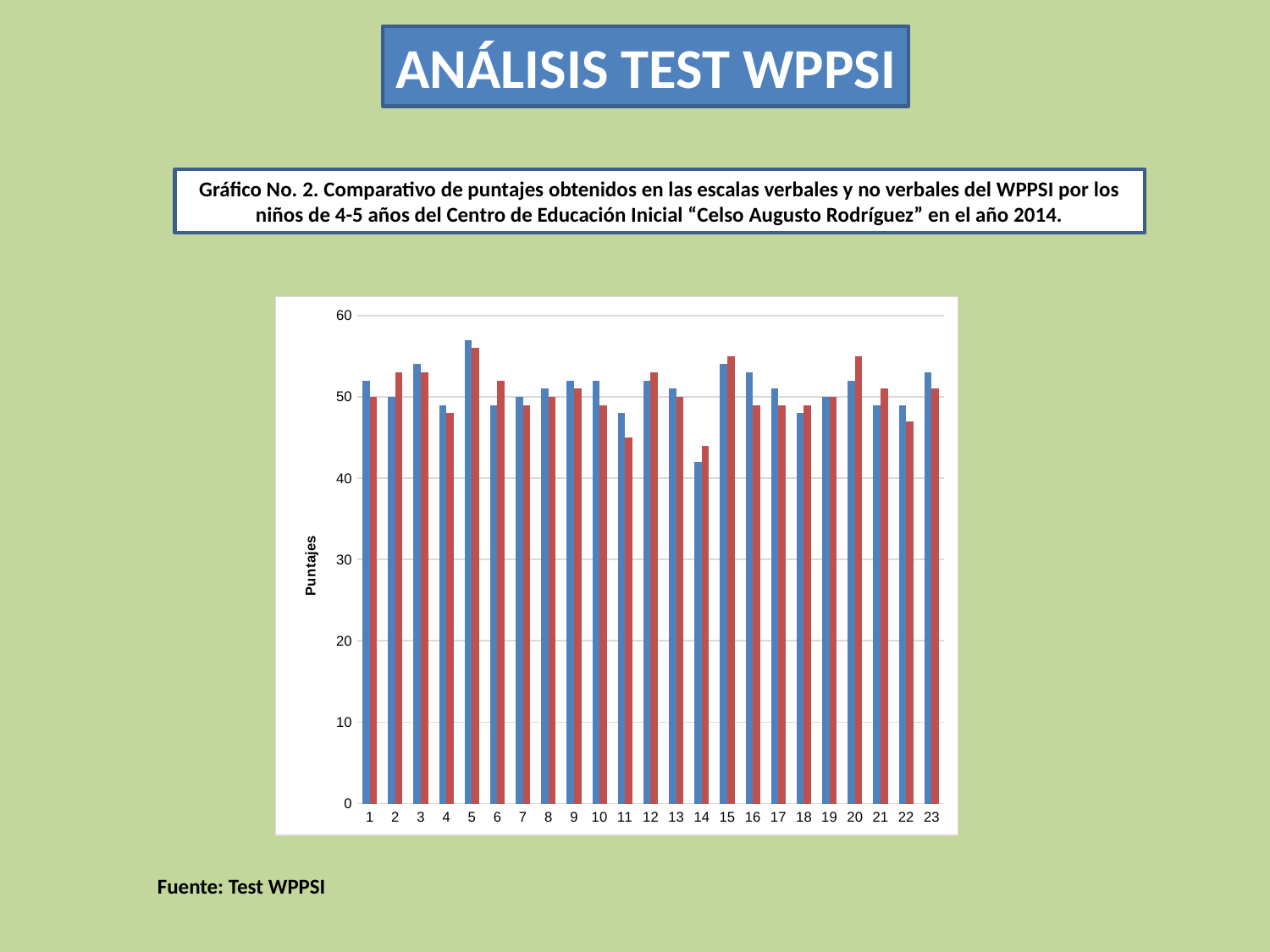
Is the value of the red bar for category 11 greater or less than 50? less How many categories are shown along the x axis of the chart? 23 How many data series (bars per category) are plotted in the chart? 2 For which category is the blue bar the shortest? 14 Is the value of the blue bar for category 5 greater or less than 50? greater What kind of chart is shown on the slide? bar chart Is the value of the red bar for category 20 greater or less than 50? greater What source is cited below the chart? Fuente: Test WPPSI For category 16, which bar is taller, the blue one or the red one? blue For which category is the blue bar the tallest? 5 What is the title of the vertical axis of the chart? Puntajes